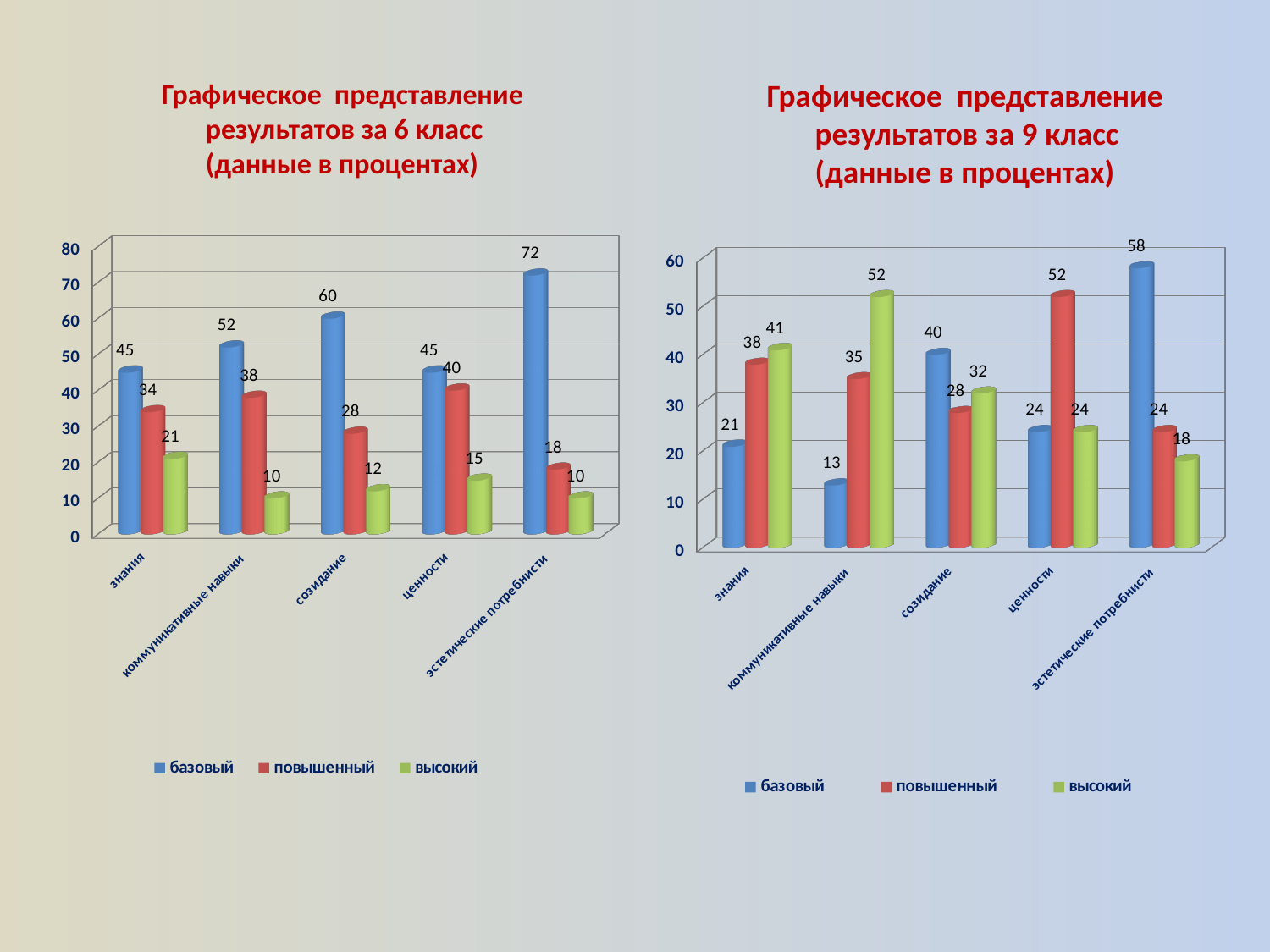
In the chart for 6 класс (left), which category has the highest базовый value? эстетические потребнисти What type of chart is used for the 9 класс results (right)? bar chart In the chart for 6 класс (left), is the повышенный value for ценности greater or less than 30? greater In the chart for 9 класс (right), which is larger for знания: базовый or повышенный? повышенный In the chart for 9 класс (right), which category has the lowest базовый value? коммуникативные навыки How many categories are shown on the x axis of the chart for 9 класс (right)? 5 In the chart for 6 класс (left), what is the value of базовый for созидание? 60 How many series does the legend of the chart for 6 класс (left) list? 3 What are the three legend entries in the chart for 6 класс (left)? базовый, повышенный, высокий In the chart for 6 класс (left), what is the difference between the базовый and высокий values for эстетические потребности? 62 In the chart for 9 класс (right), what is the value of повышенный for ценности? 52 In the chart for 9 класс (right), what is the value of высокий for коммуникативные навыки? 52